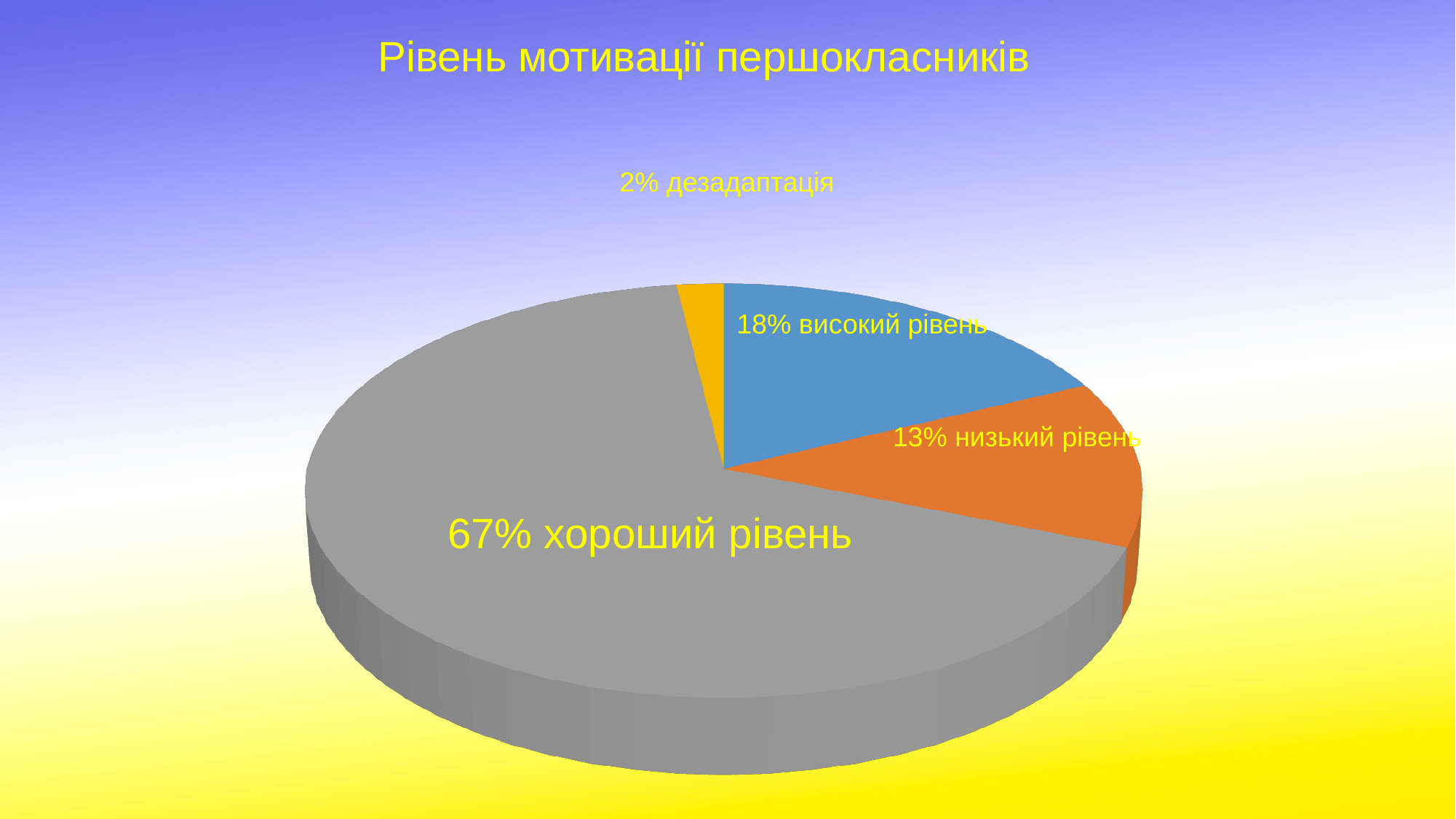
What is the difference in percentage points between "високий рівень" and "низький рівень"? 5% What share of the pie is labelled "дезадаптація"? 2% What kind of chart is shown on the slide? pie chart Which category has the smallest slice of the pie? дезадаптація What share of the pie is labelled "високий рівень"? 18% Which is larger, the share for "високий рівень" or the share for "низький рівень"? високий рівень What colour is the slice for "хороший рівень"? grey How many slices does the pie chart have? 4 What share of the pie is labelled "хороший рівень"? 67% Which category has the largest slice of the pie? хороший рівень What is the title of the chart? Рівень мотивації першокласників